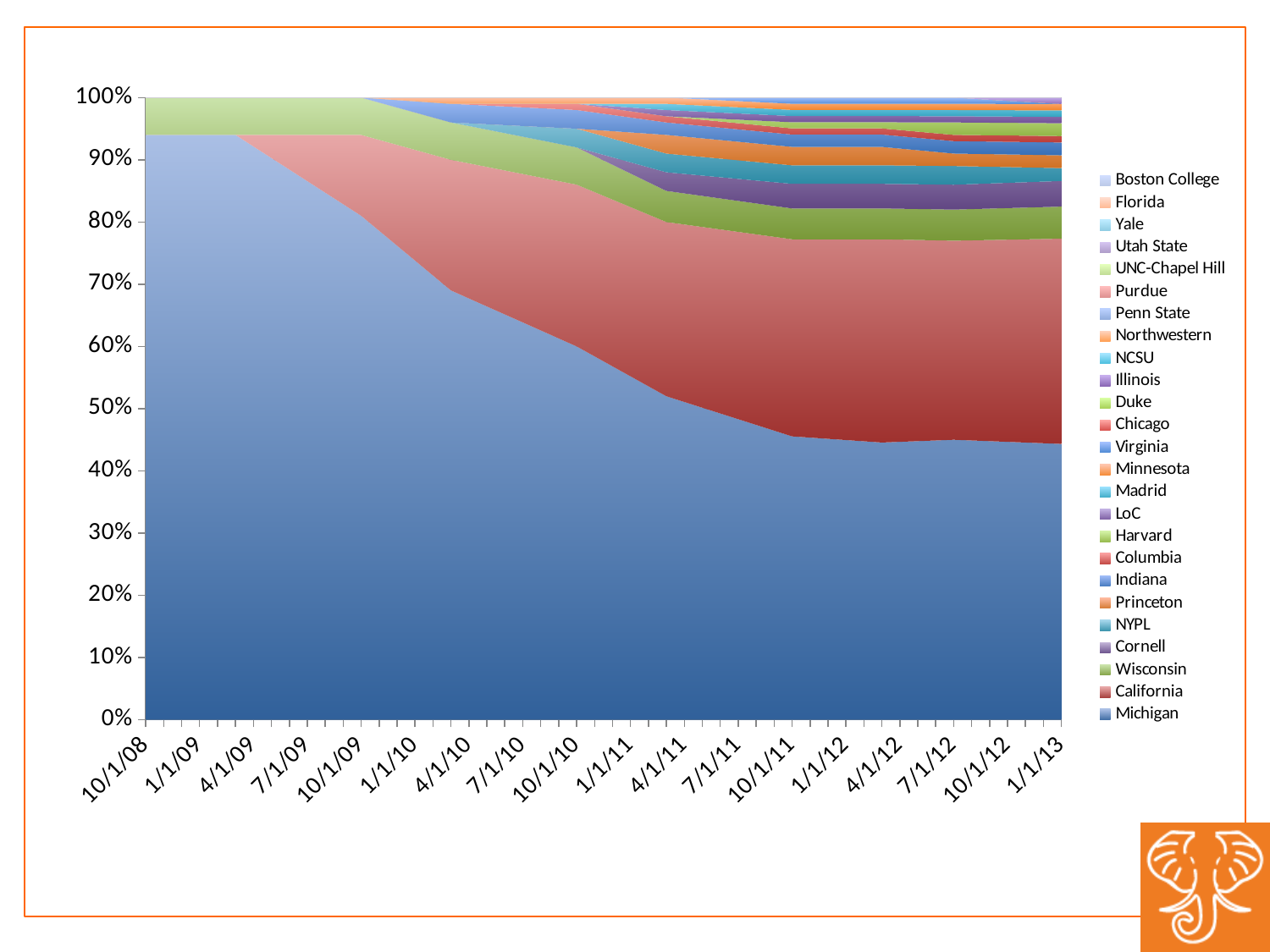
Does Michigan's share rise or fall from 10/1/08 to 1/1/13? Fall How many date labels are shown on the x axis? 18 Which series has the largest share at 1/1/13? Michigan How many series does the legend list? 25 What is the highest value shown on the y axis? 100% What kind of chart is shown on the slide? Stacked area chart Is Michigan's share at 1/1/13 greater or less than 50%? less Is California's share at 1/1/13 greater or less than 20%? greater At 1/1/13, which has the larger share, Michigan or California? Michigan Is Michigan's share at 10/1/08 greater or less than 90%? greater What is the first date label on the x axis? 10/1/08 Which series forms the bottom layer of the chart? Michigan